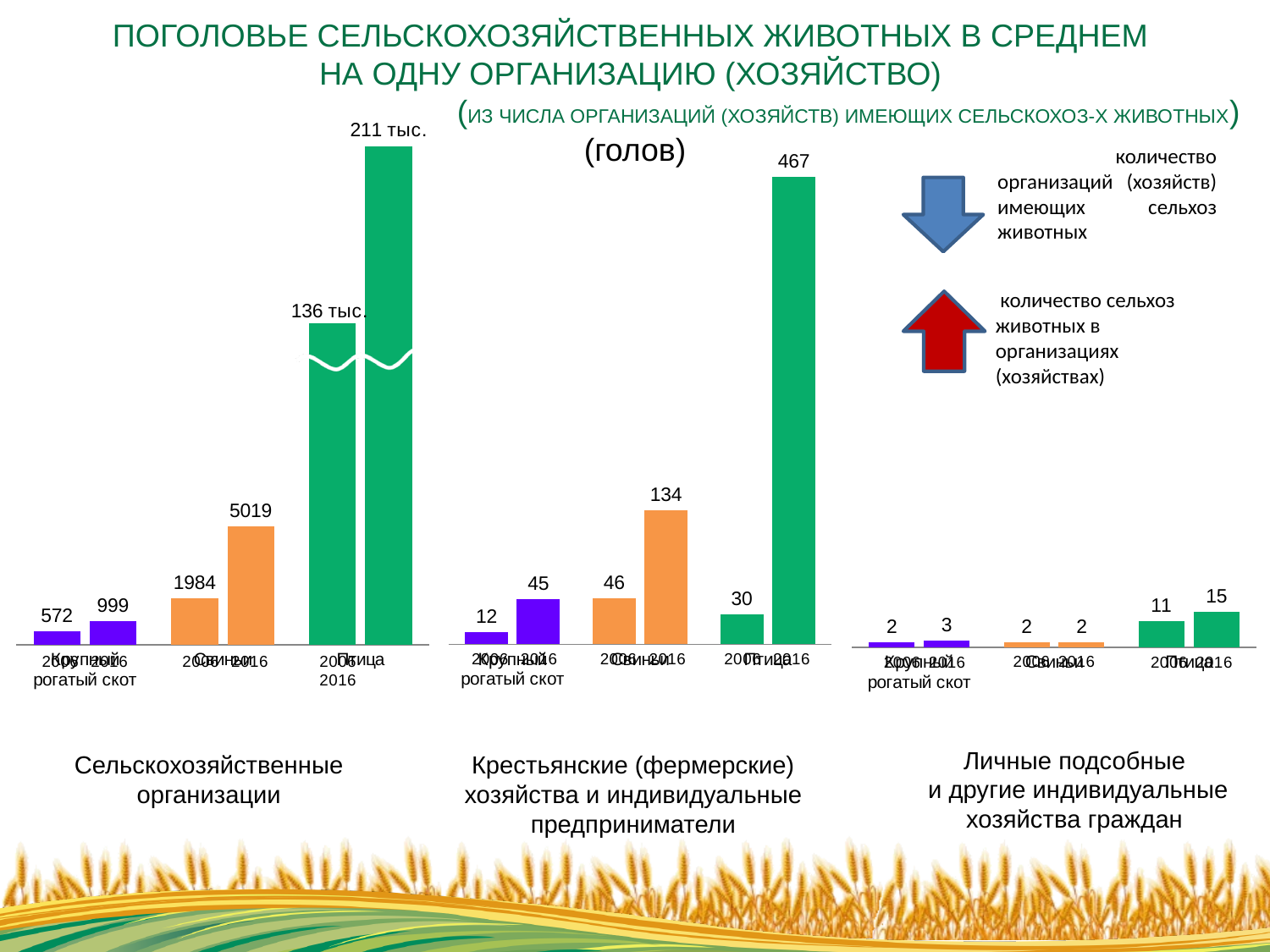
In the chart for Сельскохозяйственные организации, what is the value for Свиньи in 2016? 5019 What type of chart is used for Личные подсобные и другие индивидуальные хозяйства граждан? Bar chart In the chart for Сельскохозяйственные организации, what is the value for Крупный рогатый скот in 2006? 572 How many categories are shown on the x axis of the chart for Крестьянские (фермерские) хозяйства и индивидуальные предприниматели? 3 In the chart for Личные подсобные и другие индивидуальные хозяйства граждан, what is the value for Птица in 2006? 11 In the chart for Крестьянские (фермерские) хозяйства и индивидуальные предприниматели, what is the difference between the 2016 and 2006 values for Свиньи? 88 In the chart for Крестьянские (фермерские) хозяйства и индивидуальные предприниматели, which category has the lowest value in 2006? Крупный рогатый скот In the chart for Крестьянские (фермерские) хозяйства и индивидуальные предприниматели, what is the value for Птица in 2016? 467 In the chart for Сельскохозяйственные организации, what is the value for Птица in 2016? 211 тыс. In the chart for Сельскохозяйственные организации, which is larger: the 2006 value for Свиньи or the 2016 value for Крупный рогатый скот? 2006 value for Свиньи In the chart for Личные подсобные и другие индивидуальные хозяйства граждан, which category has the highest value in 2016? Птица In the chart for Сельскохозяйственные организации, what is the difference between the 2016 and 2006 values for Крупный рогатый скот? 427